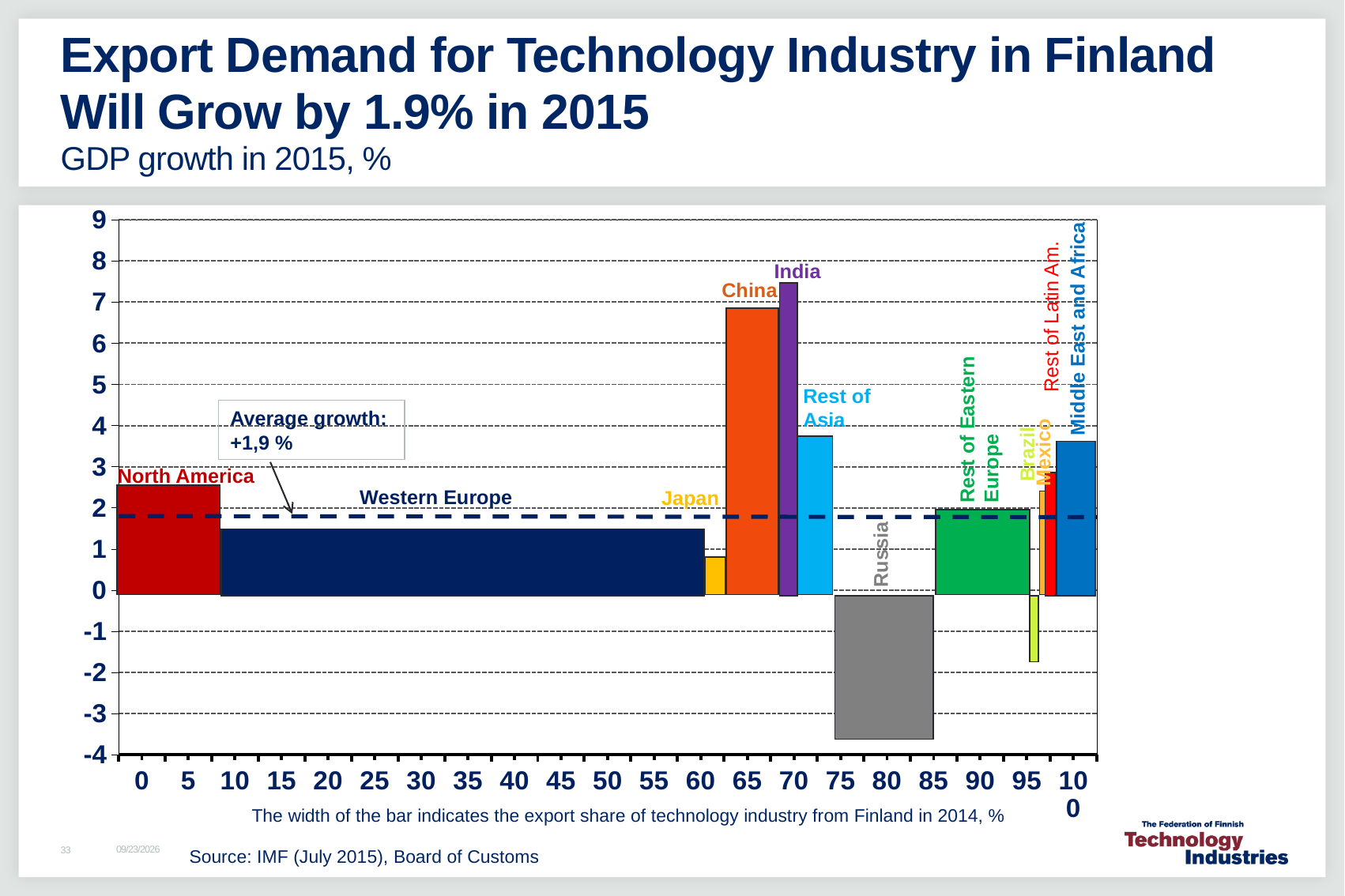
What average growth value is printed on the chart? +1,9 % Which has the higher GDP growth, China or Rest of Asia? China What kind of chart is shown on the slide? bar chart Which has the higher GDP growth, North America or Western Europe? North America Is the value for Western Europe greater or less than 2? less According to the note below the chart, what does the width of each bar indicate? The export share of technology industry from Finland in 2014, % How many regions are shown as bars on the chart? 12 Is the value for Russia greater or less than -3? less Is the value for Japan greater or less than 1? less Which region has the highest GDP growth in 2015 on the chart? India Which region has the lowest GDP growth in 2015 on the chart? Russia